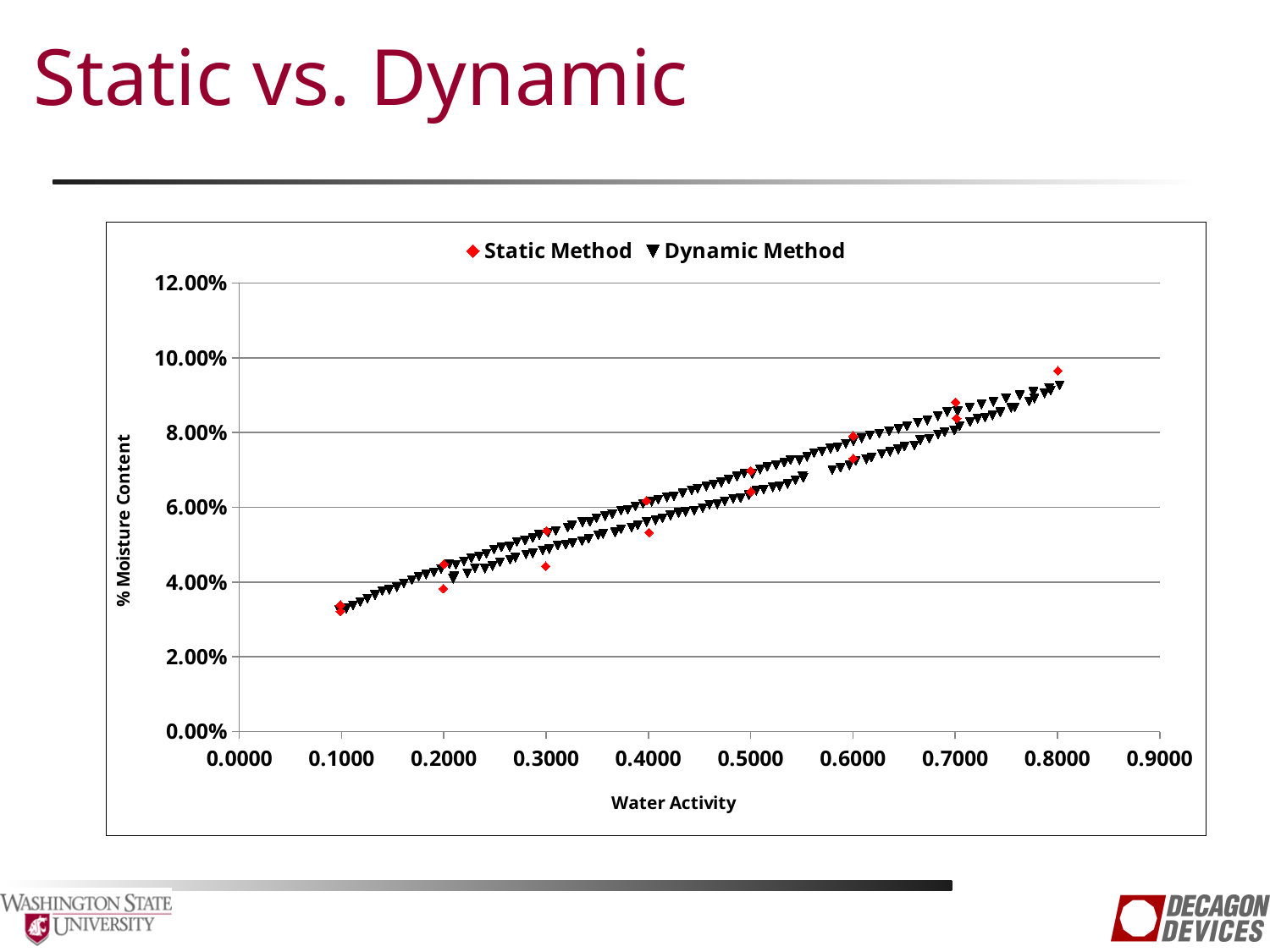
How many series does the legend list? 2 Is the Dynamic Method value at a Water Activity of 0.2000 greater or less than 6.00%? less What kind of chart is shown on the slide? scatter chart Is the Dynamic Method value at a Water Activity of 0.8000 greater or less than 8.00%? greater What is the title of the x axis? Water Activity Do the % Moisture Content values rise or fall as Water Activity increases? rise Which series is plotted with red diamond markers? Static Method Which series reaches the highest % Moisture Content on the chart? Static Method Is the Static Method value at a Water Activity of 0.3000 greater or less than 6.00%? less